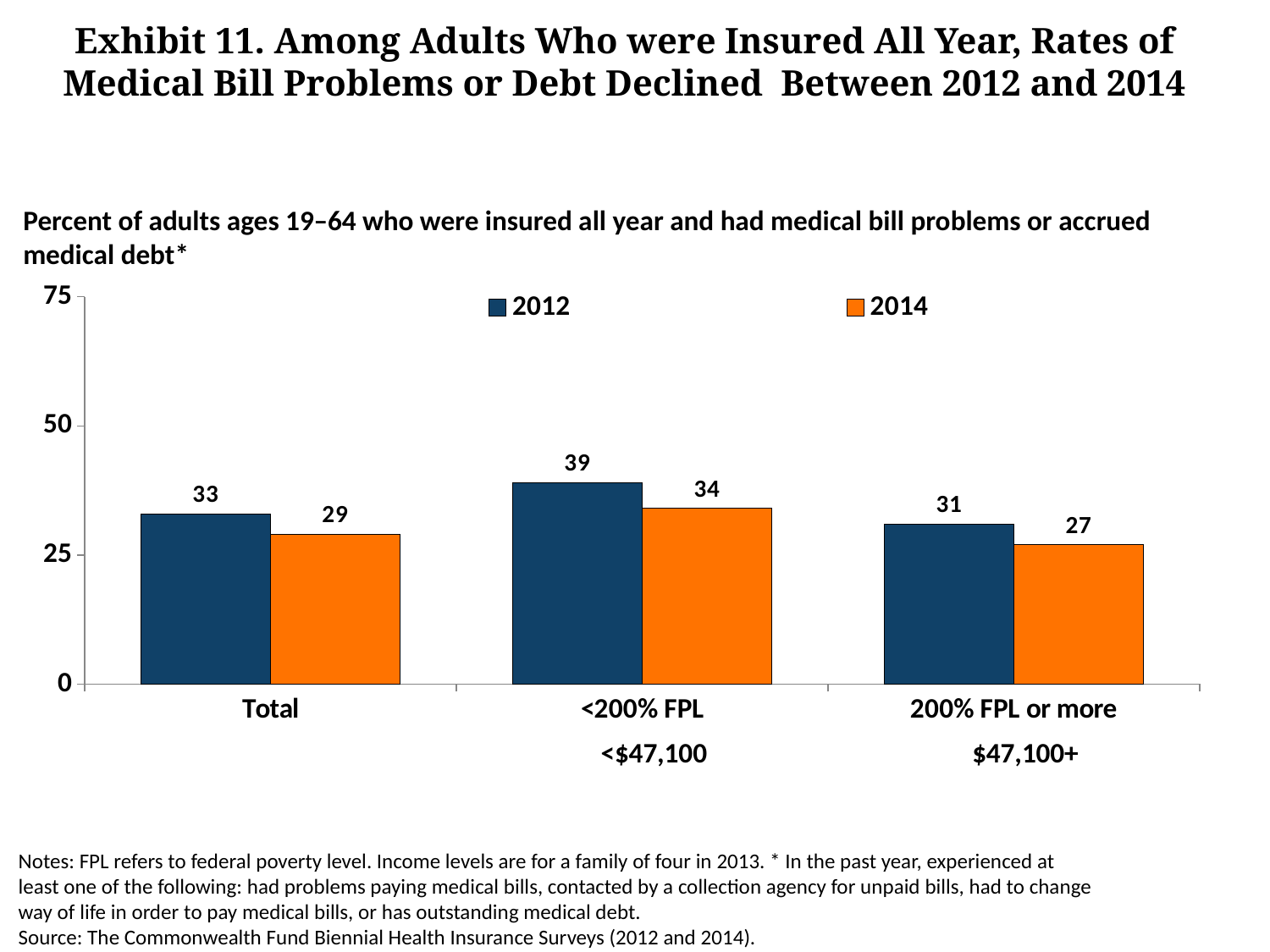
Is the 2012 value for <200% FPL greater or less than 25? greater What is the 2014 value for <200% FPL? 34 What is the 2012 value for Total? 33 What kind of chart is shown on the slide? bar chart Which is larger, the 2012 value for Total or the 2012 value for 200% FPL or more? 2012 value for Total What is the 2014 value for 200% FPL or more? 27 Which category has the highest 2012 value? <200% FPL How many categories are shown on the x axis? 3 Which category has the lowest 2014 value? 200% FPL or more How many series does the legend list? 2 What is the difference between the 2012 and 2014 values for Total? 4 What is the difference between the 2012 and 2014 values for <200% FPL? 5